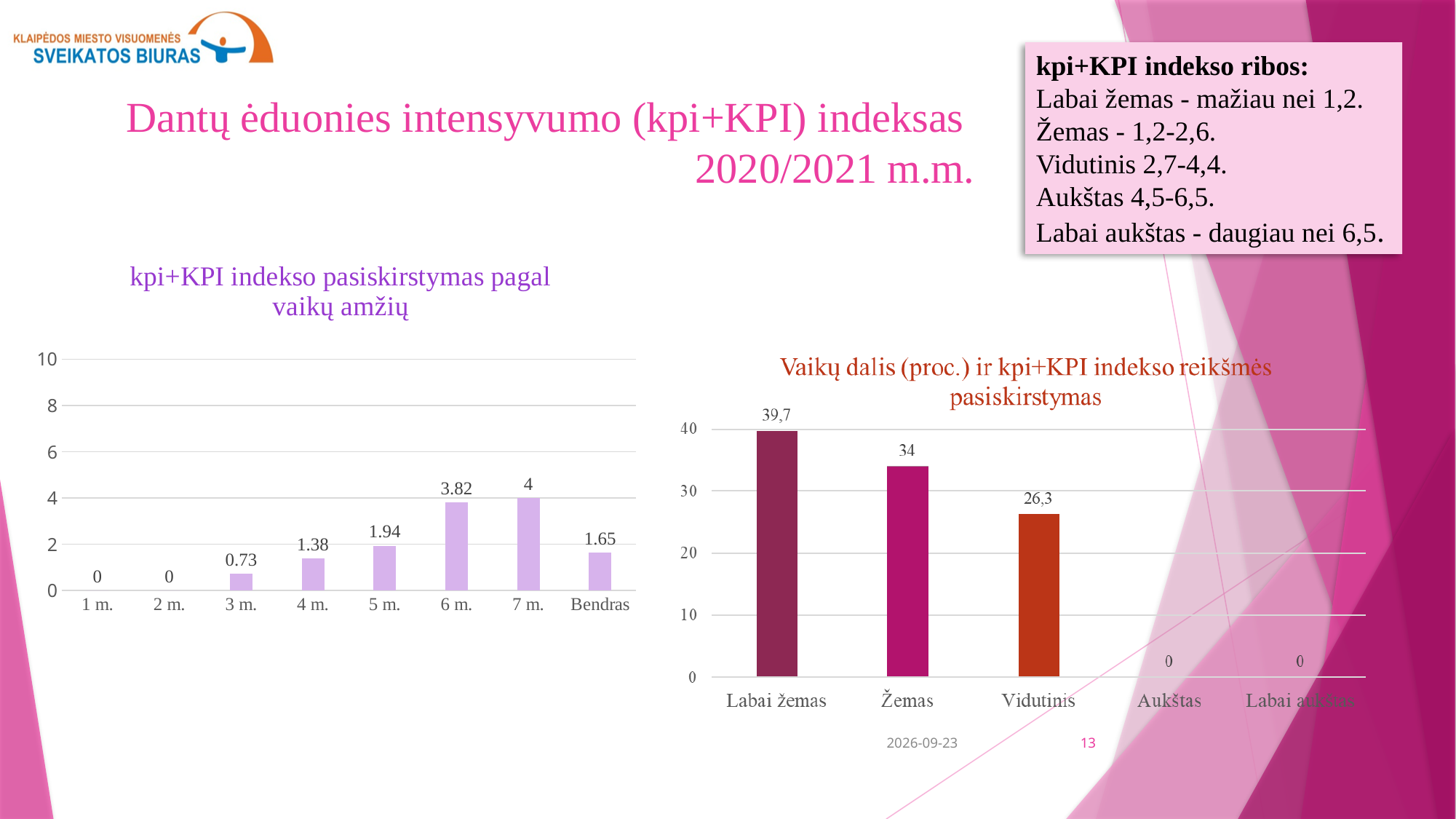
In the chart 'kpi+KPI indekso pasiskirstymas pagal vaikų amžių', which category has the highest value? 7 m. In the chart 'kpi+KPI indekso pasiskirstymas pagal vaikų amžių', what is the difference between the values for 7 m. and 6 m.? 0.18 In the chart 'Vaikų dalis (proc.) ir kpi+KPI indekso reikšmės pasiskirstymas', how many categories are shown on the x axis? 5 In the chart 'kpi+KPI indekso pasiskirstymas pagal vaikų amžių', how many categories are shown on the x axis? 8 What kind of chart is 'Vaikų dalis (proc.) ir kpi+KPI indekso reikšmės pasiskirstymas'? bar chart In the chart 'kpi+KPI indekso pasiskirstymas pagal vaikų amžių', do the values rise or fall from 3 m. to 7 m.? rise In the chart 'kpi+KPI indekso pasiskirstymas pagal vaikų amžių', what is the value for Bendras? 1.65 In the chart 'Vaikų dalis (proc.) ir kpi+KPI indekso reikšmės pasiskirstymas', what is the value for Žemas? 34 In the chart 'Vaikų dalis (proc.) ir kpi+KPI indekso reikšmės pasiskirstymas', which category has the highest value? Labai žemas In the chart 'kpi+KPI indekso pasiskirstymas pagal vaikų amžių', what is the value for 6 m.? 3.82 In the chart 'kpi+KPI indekso pasiskirstymas pagal vaikų amžių', which is larger, the value for 4 m. or the value for 5 m.? 5 m. In the chart 'Vaikų dalis (proc.) ir kpi+KPI indekso reikšmės pasiskirstymas', what is the difference between the values for Labai žemas and Vidutinis? 13,4